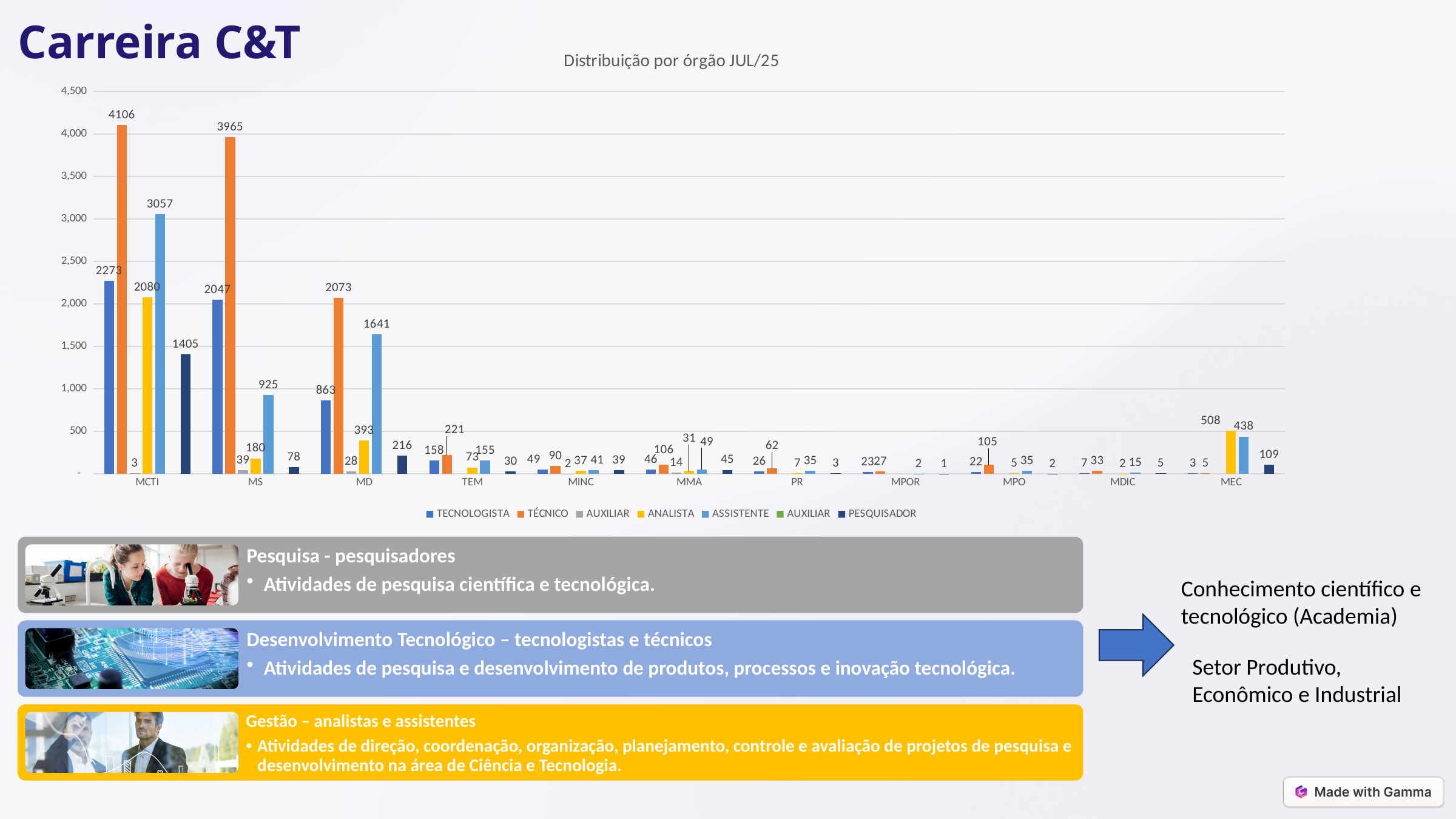
What is the value for TÉCNICO at MCTI? 4106 What is the value for ASSISTENTE at MD? 1641 What kind of chart is shown? Bar chart How many órgãos (categories) are shown on the x axis? 11 What is the value for ANALISTA at MEC? 508 What is the title of the chart? Distribuição por órgão JUL/25 Which órgão has the highest TECNOLOGISTA value? MCTI How many series does the legend list? 7 What is the value for PESQUISADOR at MCTI? 1405 Which is larger, the ASSISTENTE value for MCTI or for MS? MCTI Which órgão has the highest TÉCNICO value? MCTI What is the difference between the TÉCNICO values for MCTI and MS? 141